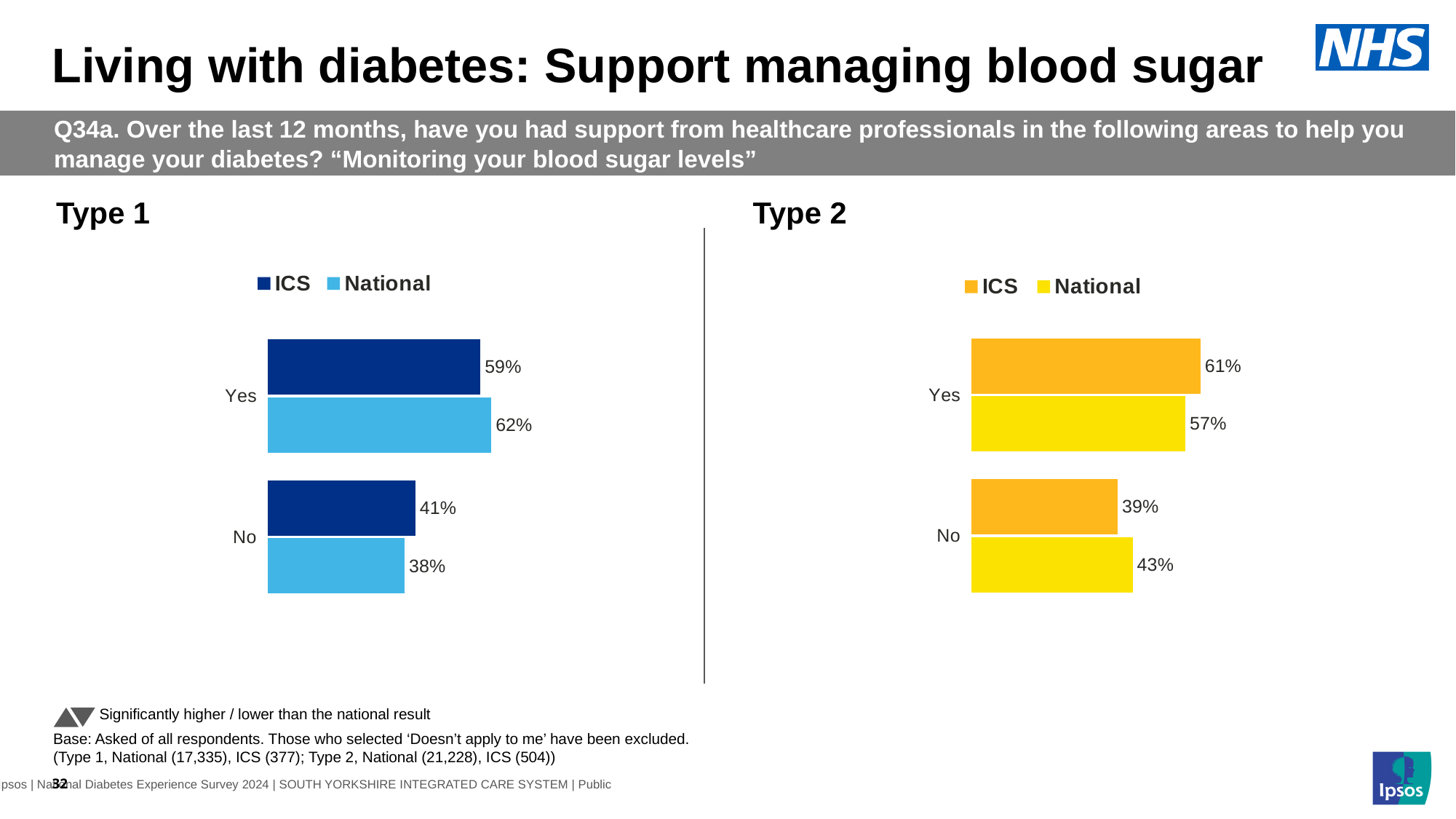
In the Type 1 chart, what is the National value for No? 38% How many series does the legend of the Type 2 chart list? 2 In the Type 2 chart, which is larger for Yes: ICS or National? ICS In the Type 2 chart, what is the National value for No? 43% In the Type 2 chart, what is the ICS value for Yes? 61% What kind of chart is the Type 2 chart? Bar chart How many categories are shown in the Type 1 chart? 2 In the Type 1 chart, what is the difference between the National and ICS values for Yes? 3% In the Type 2 chart, what is the difference between the National and ICS values for No? 4% In the Type 1 chart, which category has the highest ICS value? Yes In the Type 1 chart, which is larger for No: ICS or National? ICS In the Type 1 chart, what is the ICS value for Yes? 59%